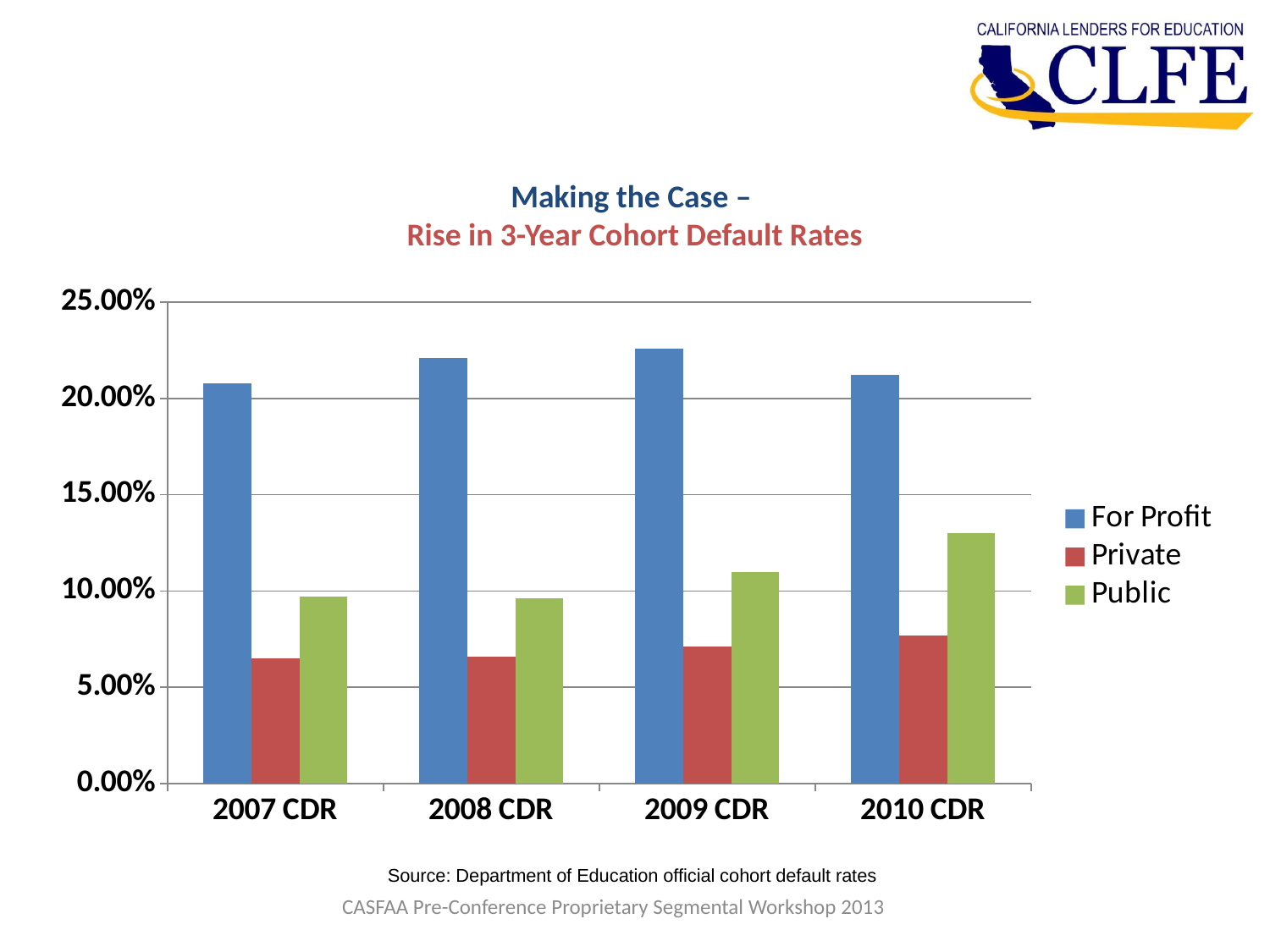
In which cohort year is the Private default rate lowest? 2007 CDR Which series is shown in blue in the legend? For Profit Is the Public value for 2010 CDR greater or less than 10.00%? greater How many cohort years are shown on the x axis? 4 In which cohort year is the For Profit default rate highest? 2009 CDR How many series does the legend list? 3 For 2010 CDR, which is larger, the Public value or the Private value? Public Is the For Profit value for 2007 CDR greater or less than 20.00%? greater Do the Private default rates rise or fall from 2007 CDR to 2010 CDR? Rise In which cohort year is the Public default rate highest? 2010 CDR Is the Public value for 2007 CDR greater or less than 10.00%? less What kind of chart is shown on the slide? Bar chart